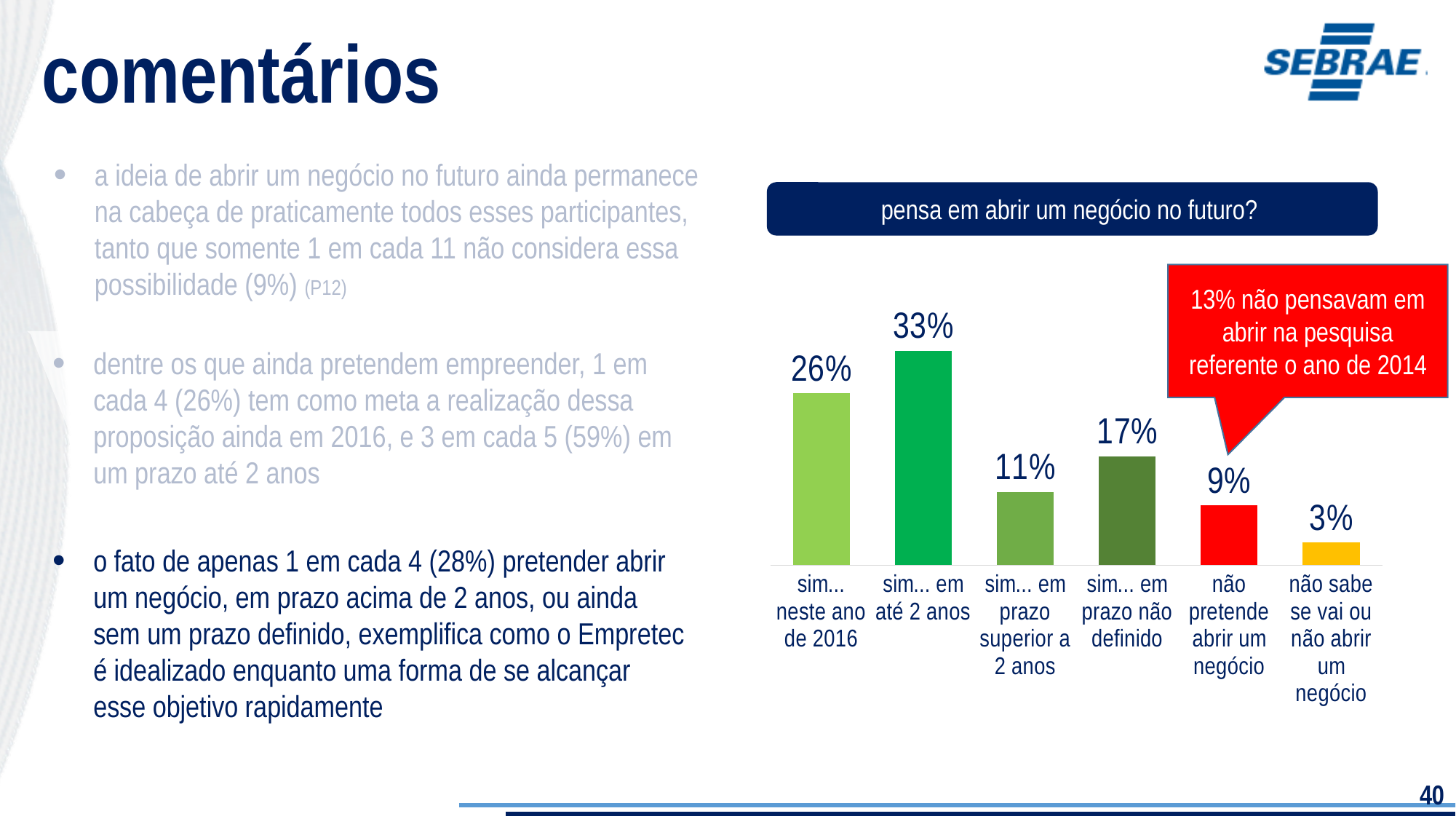
What is the value for "sim... em prazo não definido"? 17% What is the difference between "não pretende abrir um negócio" and "não sabe se vai ou não abrir um negócio"? 6% How many categories are shown in the chart? 6 What is the title of the chart? pensa em abrir um negócio no futuro? What kind of chart is shown on the slide? bar chart What is the value for "não pretende abrir um negócio"? 9% What is the difference between "sim... em até 2 anos" and "sim... neste ano de 2016"? 7% What is the value for "sim... em até 2 anos"? 33% According to the callout on the chart, what percentage did not think about opening a business in the survey for 2014? 13% Which category has the lowest value? não sabe se vai ou não abrir um negócio Which category has the highest value? sim... em até 2 anos Which is larger: "sim... em prazo superior a 2 anos" or "sim... em prazo não definido"? sim... em prazo não definido